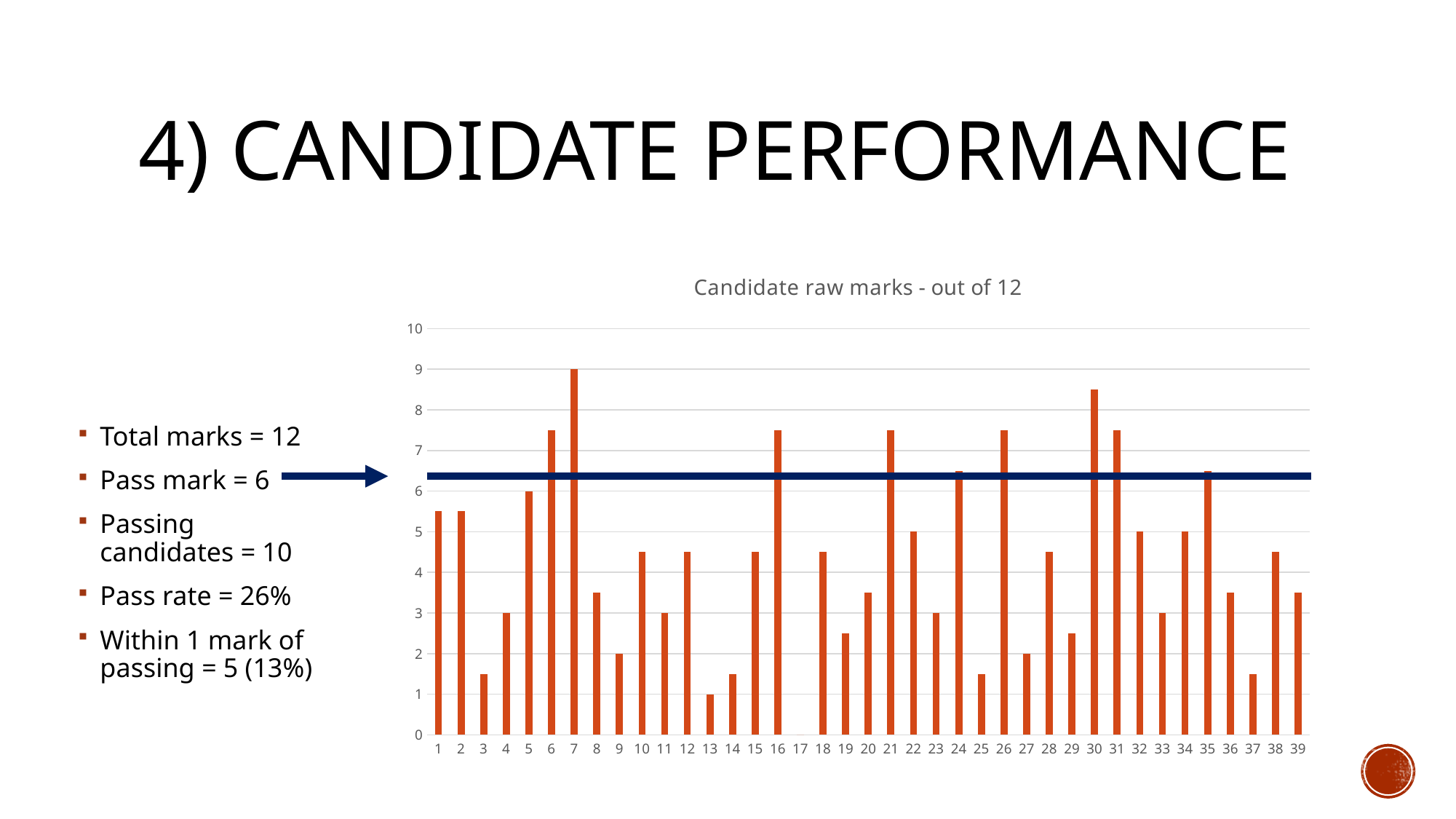
How many candidates are shown on the x axis of the chart? 39 What is the raw mark for candidate 7? 9 What is the raw mark for candidate 5? 6 What is the difference between the raw marks of candidate 7 and candidate 5? 3 What is the raw mark for candidate 13? 1 What is the title of the chart? Candidate raw marks - out of 12 Which candidate has the higher raw mark, candidate 6 or candidate 8? candidate 6 What type of chart is shown on the slide? bar chart Is the raw mark for candidate 25 greater or less than 2? less What is the raw mark for candidate 22? 5 Is the raw mark for candidate 30 greater or less than 8? greater Which candidate has the highest raw mark? 7